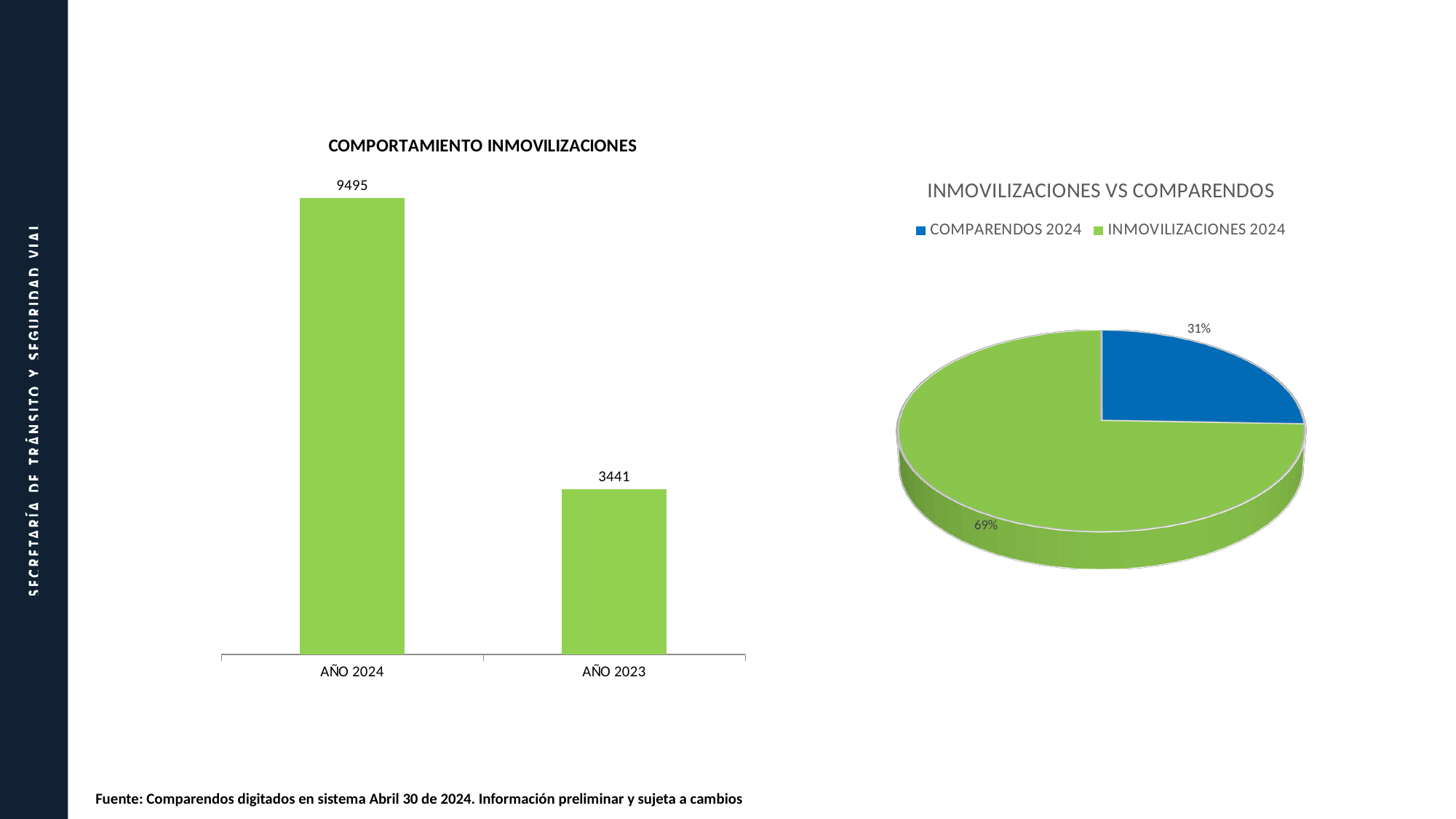
In the chart titled COMPORTAMIENTO INMOVILIZACIONES, how many categories are shown on the x axis? 2 In the chart titled INMOVILIZACIONES VS COMPARENDOS, what share does INMOVILIZACIONES 2024 have? 69% What kind of chart is the one titled COMPORTAMIENTO INMOVILIZACIONES? Bar chart In the chart titled INMOVILIZACIONES VS COMPARENDOS, what share does COMPARENDOS 2024 have? 31% In the chart titled INMOVILIZACIONES VS COMPARENDOS, how many entries does the legend list? 2 In the chart titled COMPORTAMIENTO INMOVILIZACIONES, what is the value for AÑO 2024? 9495 In the chart titled COMPORTAMIENTO INMOVILIZACIONES, what is the difference between the values for AÑO 2024 and AÑO 2023? 6054 In the chart titled COMPORTAMIENTO INMOVILIZACIONES, what is the value for AÑO 2023? 3441 In the chart titled INMOVILIZACIONES VS COMPARENDOS, which slice is larger, COMPARENDOS 2024 or INMOVILIZACIONES 2024? INMOVILIZACIONES 2024 What kind of chart is the one titled INMOVILIZACIONES VS COMPARENDOS? Pie chart In the chart titled COMPORTAMIENTO INMOVILIZACIONES, which category has the highest value? AÑO 2024 In the chart titled COMPORTAMIENTO INMOVILIZACIONES, which category has the lowest value? AÑO 2023